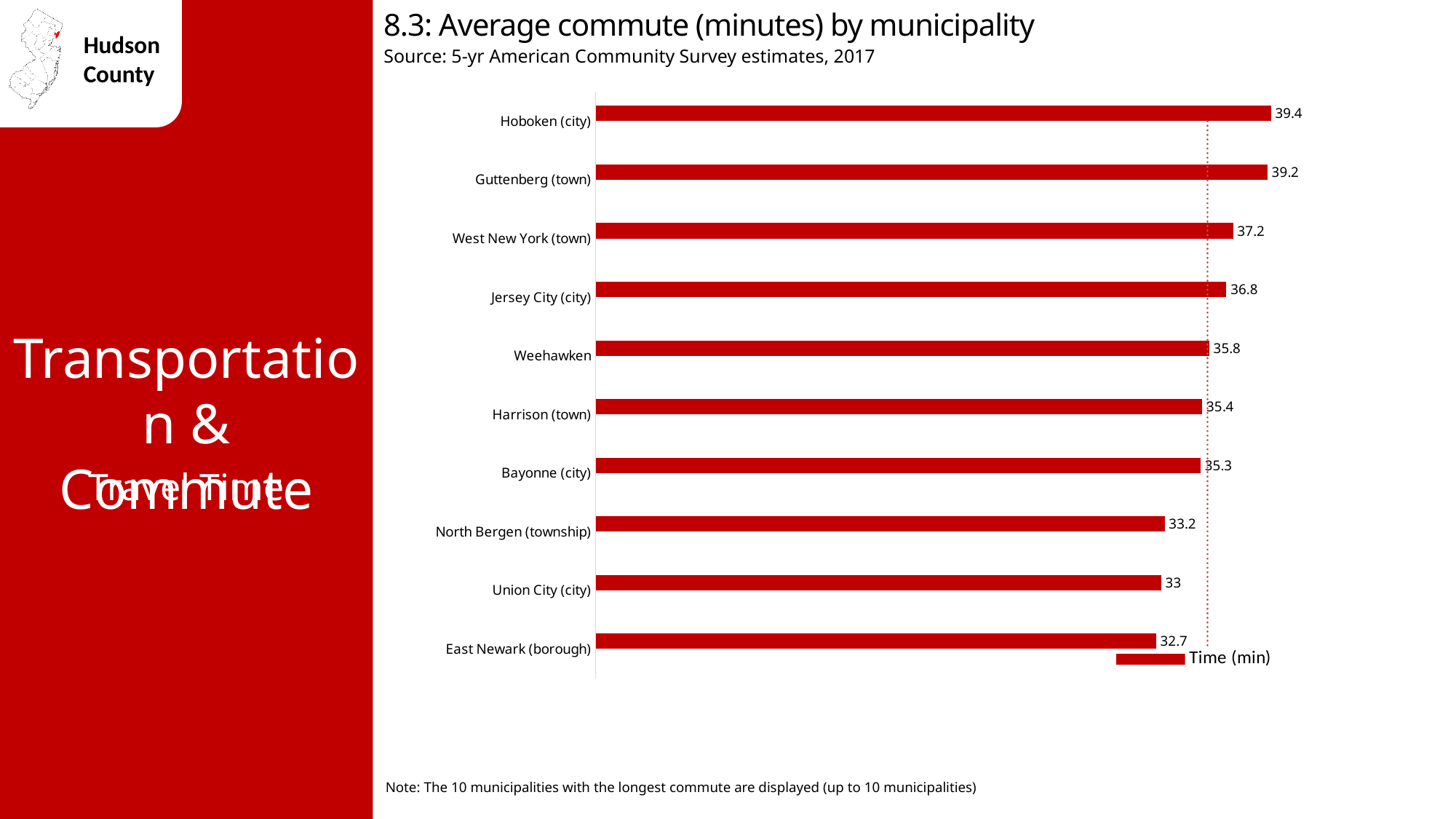
What is the difference in average commute time between Hoboken (city) and East Newark (borough)? 6.7 What is the difference in average commute time between West New York (town) and Union City (city)? 4.2 How many municipalities are shown in the chart? 10 What is the legend entry for the series in the chart? Time (min) Which municipality has the shortest average commute among those shown? East Newark (borough) Which municipality has the longest average commute? Hoboken (city) What type of chart is shown on the slide? Bar chart What is the average commute time for Jersey City (city)? 36.8 What is the average commute time for East Newark (borough)? 32.7 What is the average commute time for Hoboken (city)? 39.4 Which has a longer average commute, Weehawken or Bayonne (city)? Weehawken What is the average commute time for North Bergen (township)? 33.2